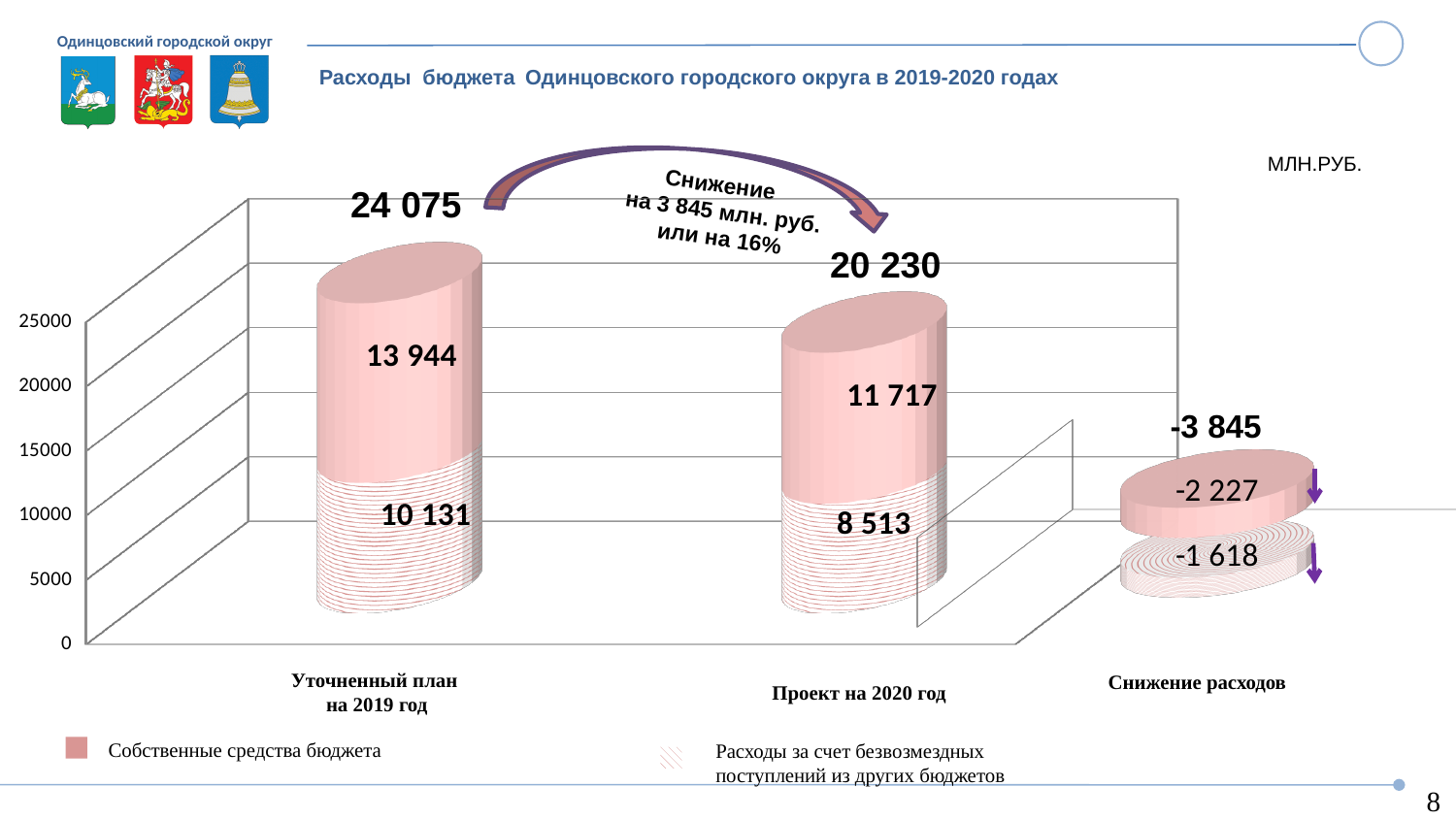
Is the total for 'Проект на 2020 год' greater or less than 20000? greater What is the difference between the 'Собственные средства бюджета' values for 2019 and 2020? 2 227 What is the total value shown for 'Уточненный план на 2019 год'? 24 075 How many categories are shown on the x axis? 3 What is the value of 'Расходы за счет безвозмездных поступлений из других бюджетов' for 'Уточненный план на 2019 год'? 10 131 What kind of chart is shown on the slide? Stacked bar chart What unit is indicated for the chart values? МЛН.РУБ. How many series does the legend list? 2 What is the value of 'Собственные средства бюджета' for 'Проект на 2020 год'? 11 717 What is the total value shown for 'Снижение расходов'? -3 845 What is the total value shown for 'Проект на 2020 год'? 20 230 Which is larger: 'Собственные средства бюджета' for 2019 or for 2020? 2019